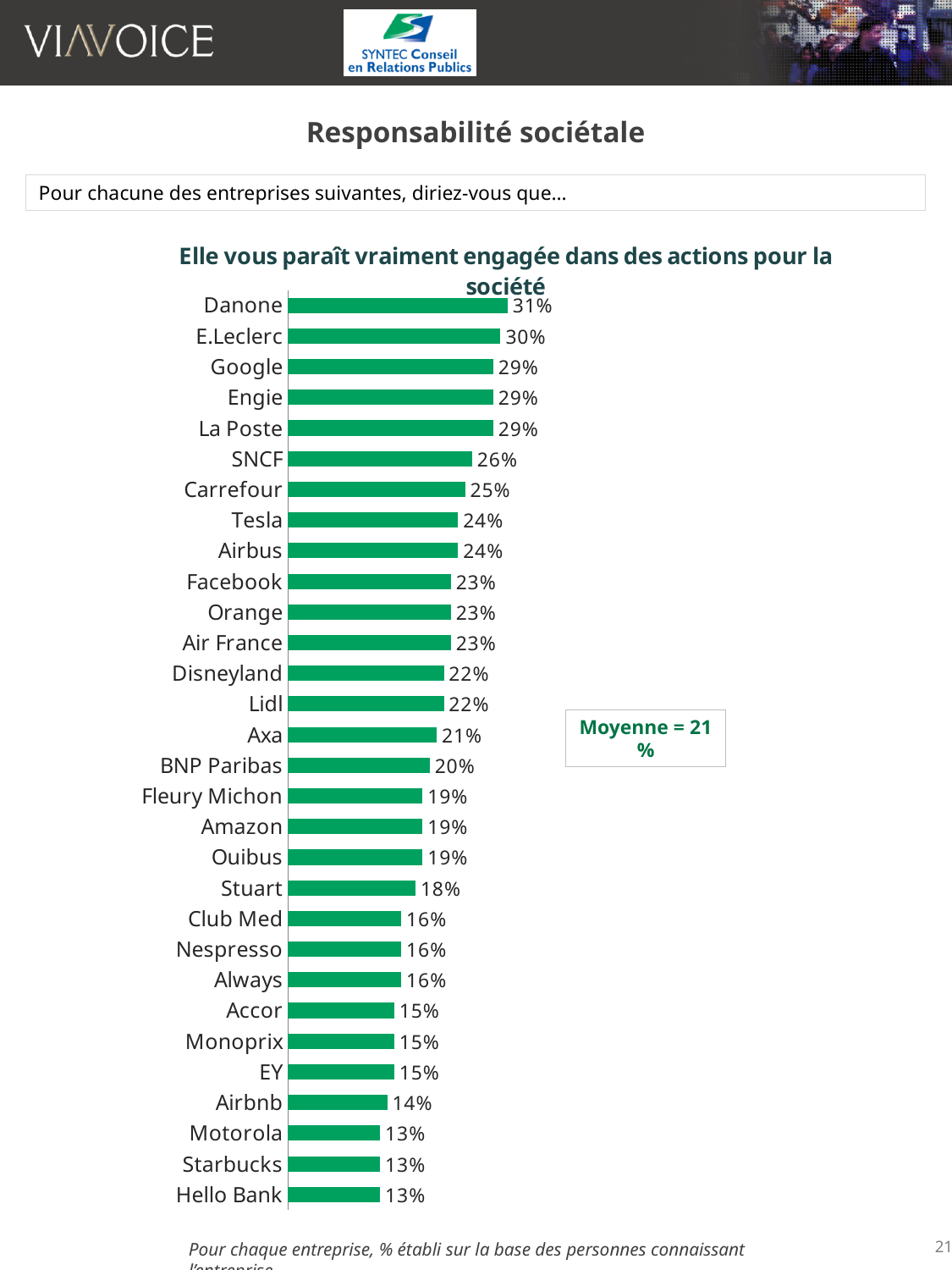
What average value (Moyenne) is shown in the box next to the chart? 21% What is the value for Danone? 31% Which has a larger value, Axa or E.Leclerc? E.Leclerc What is the difference between the values for Danone and Hello Bank? 18% What is the difference between the values for Carrefour and Stuart? 7% What is the value for SNCF? 26% Which has a larger value, Tesla or Club Med? Tesla What kind of chart is shown on the slide? Bar chart What is the value for BNP Paribas? 20% What is the value for Airbnb? 14% How many companies are shown in the chart? 30 Which company has the highest value? Danone